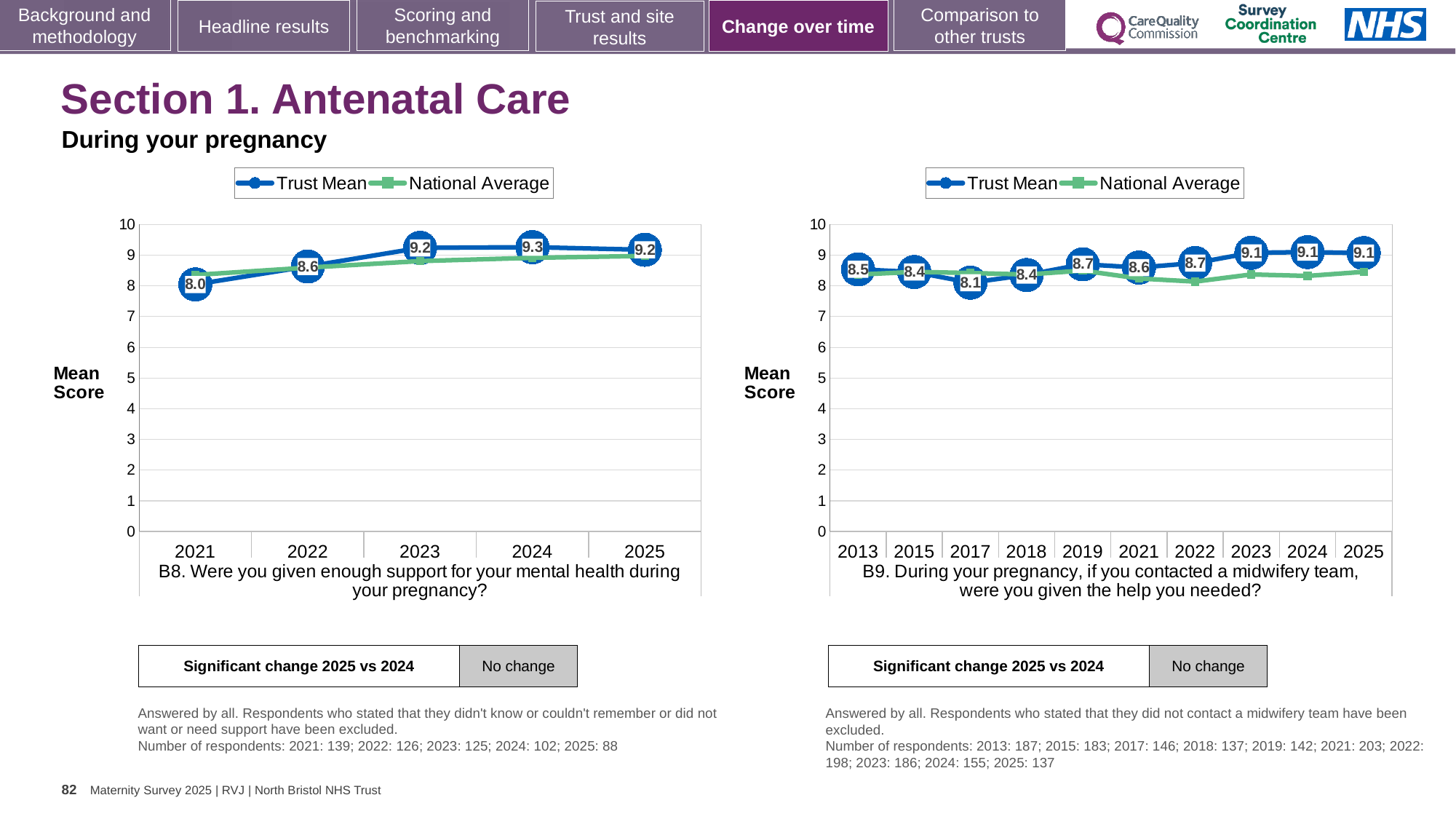
In the B9 chart (right), is the Trust Mean for 2019 larger or smaller than the Trust Mean for 2017? larger In the B9 chart (right), what is the Trust Mean for 2025? 9.1 How many series does the legend of the B9 chart (right) list? 2 In the B8 chart (left), what is the Trust Mean for 2024? 9.3 In the B8 chart (left), which year has the lowest Trust Mean? 2021 In the B8 chart (left), how many years are shown on the x axis? 5 In the B9 chart (right), how many years are shown on the x axis? 10 What kind of chart is the B8 chart (left)? Line chart In the B9 chart (right), what is the Trust Mean for 2017? 8.1 In the B8 chart (left), what is the Trust Mean for 2021? 8.0 In the B8 chart (left), what is the difference between the Trust Mean for 2024 and 2021? 1.3 In the B9 chart (right), which year has the lowest Trust Mean? 2017